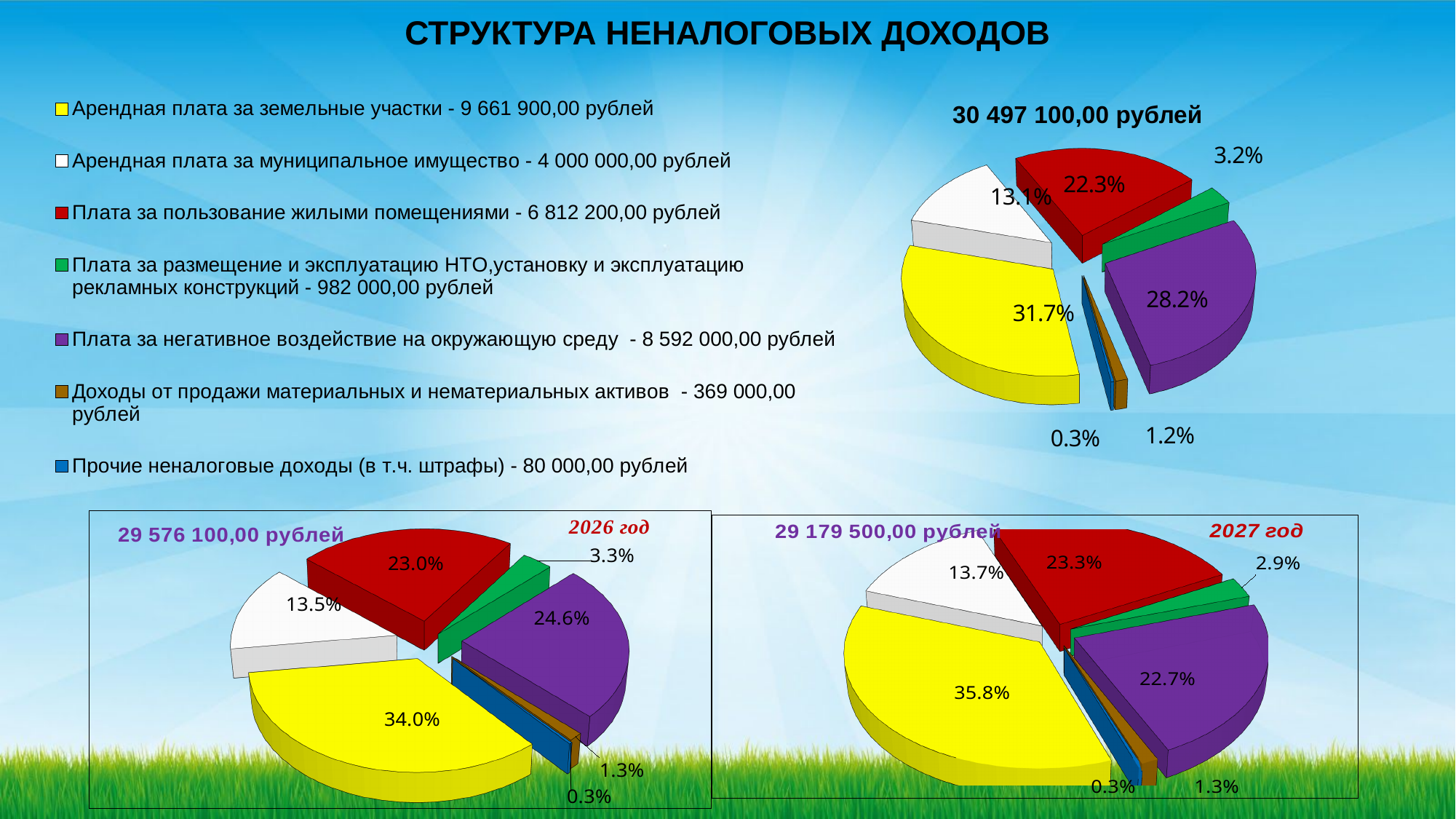
In the 2027 год pie chart, which is larger: the share for Арендная плата за муниципальное имущество (white) or the share for Плата за пользование жилыми помещениями (red)? Плата за пользование жилыми помещениями In the top-right pie chart (30 497 100,00 рублей), what share is shown for Плата за негативное воздействие на окружающую среду (purple slice)? 28.2% In the 2026 год pie chart, which category has the largest share? Арендная плата за земельные участки In the 2027 год pie chart, what share is shown for Арендная плата за земельные участки (yellow slice)? 35.8% In the top-right pie chart (30 497 100,00 рублей), what share is shown for Арендная плата за земельные участки (yellow slice)? 31.7% How many categories does the legend list? 7 How many pie charts are on the slide? 3 In the 2027 год pie chart, what is the difference between the yellow slice (35.8%) and the purple slice (22.7%)? 13.1% In the top-right pie chart (30 497 100,00 рублей), which category has the smallest share? Прочие неналоговые доходы (в т.ч. штрафы) What type of chart is used on this slide? Pie chart What total amount is shown above the 2027 год pie chart? 29 179 500,00 рублей